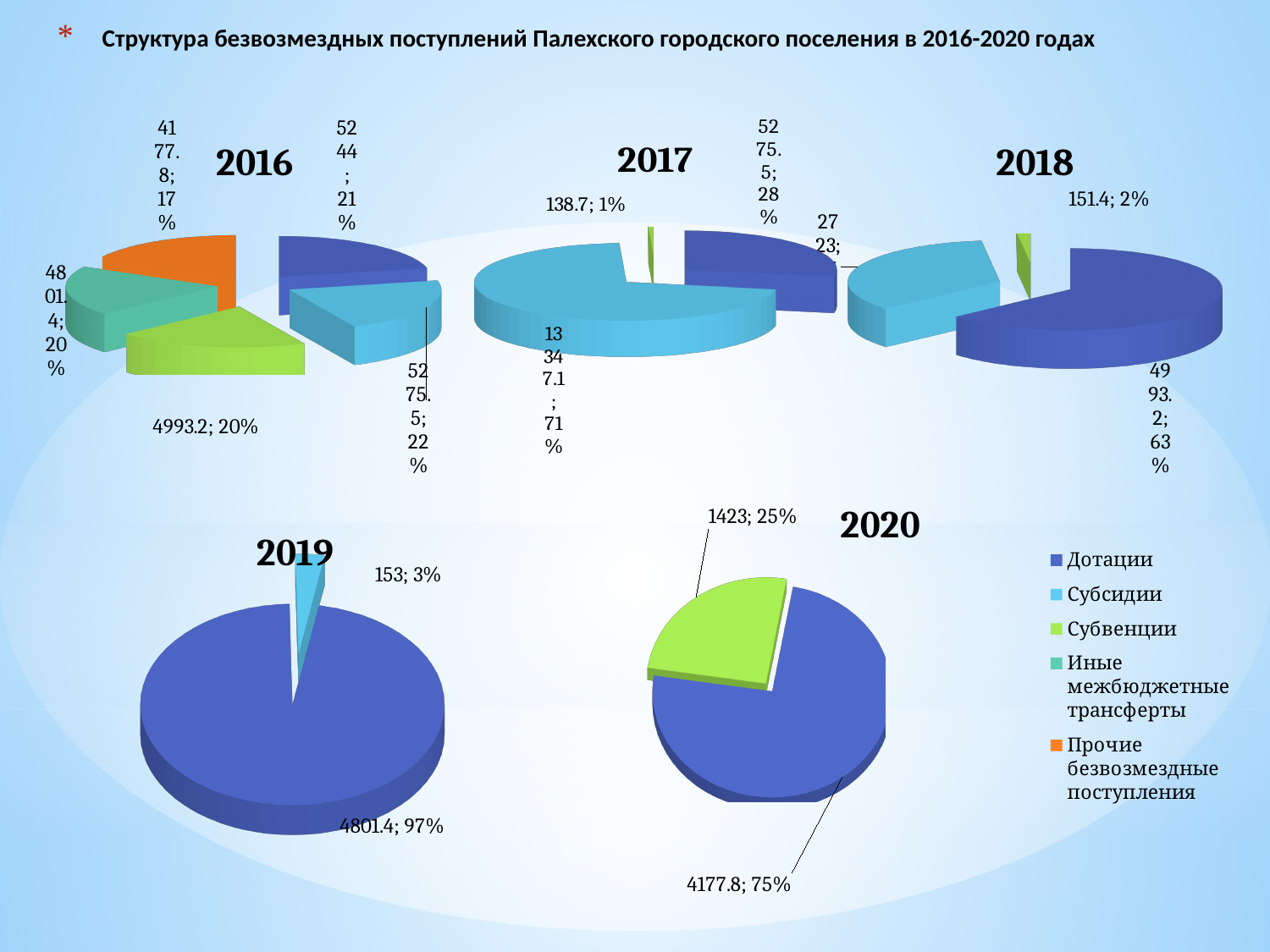
In the 2019 pie chart, what value and share are shown for Дотации? 4801.4; 97% In the 2020 pie chart, what value is shown for Субвенции? 1423 In the 2020 pie chart, what share does the Дотации slice have? 75% In the 2017 pie chart, what value is shown for Субвенции? 138.7 How many categories does the legend list? 5 In the 2016 pie chart, what share does the Прочие безвозмездные поступления slice have? 17% What kind of charts are shown on the slide? Pie charts In the 2016 pie chart, how many slices are there? 5 In the 2017 pie chart, what share does the Субсидии slice have? 71% In the 2018 pie chart, what value and share are shown for Субвенции? 151.4; 2% In the 2018 pie chart, which category has the largest slice? Дотации